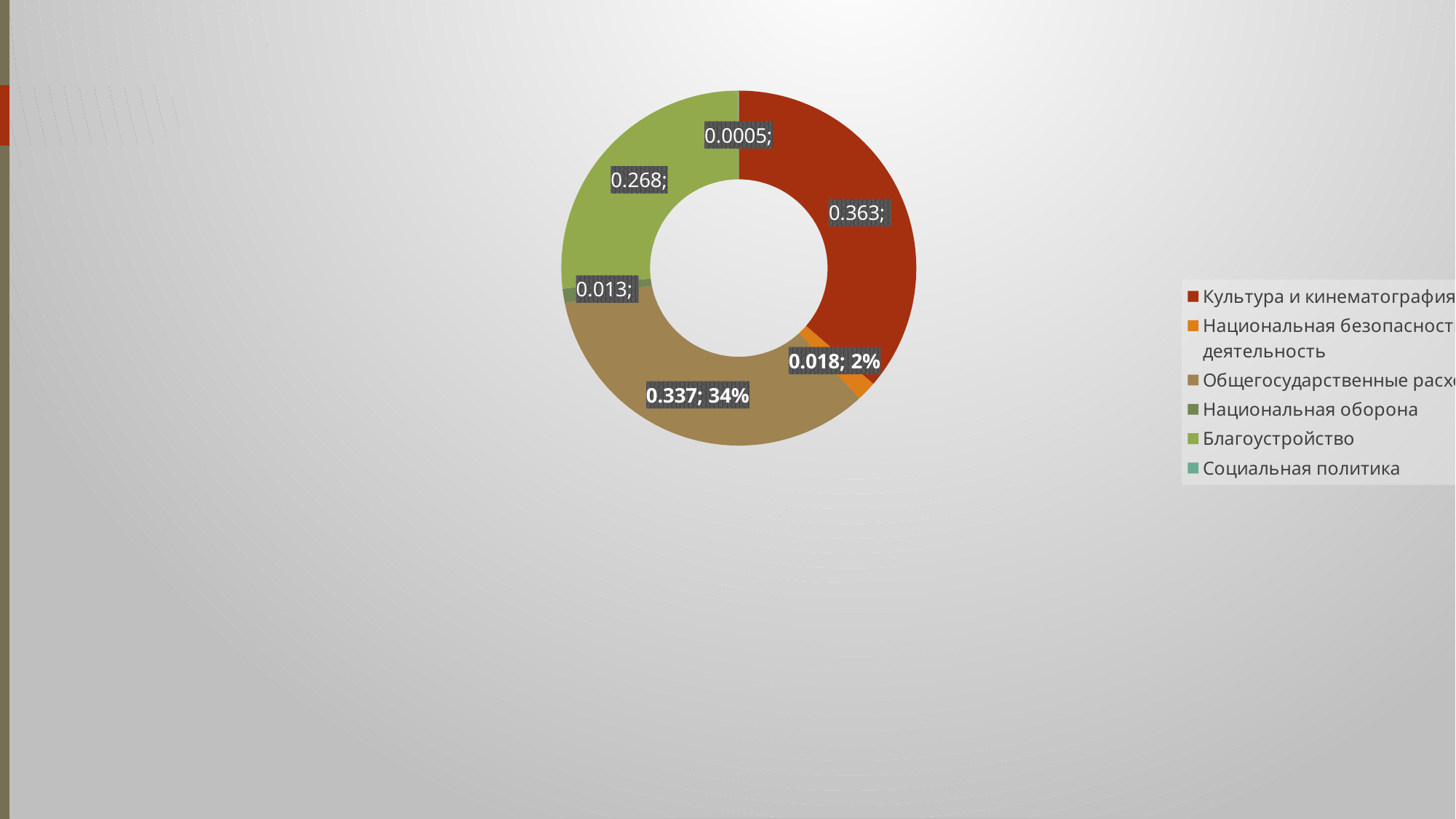
What colour represents Благоустройство in the chart? light green What value is shown for Благоустройство? 0.268 Which category has the smallest value? Социальная политика What value is shown for Культура и кинематография? 0.363 What is the difference between the values for Культура и кинематография and Благоустройство? 0.095 Which is larger, Благоустройство or Национальная оборона? Благоустройство Which category has the largest value? Культура и кинематография What kind of chart is shown on the slide? doughnut (pie) chart What percentage share is printed for the slice labelled 0.337? 34% What value is shown for Национальная оборона? 0.013 What value is shown for Социальная политика? 0.0005 How many categories does the legend list? 6